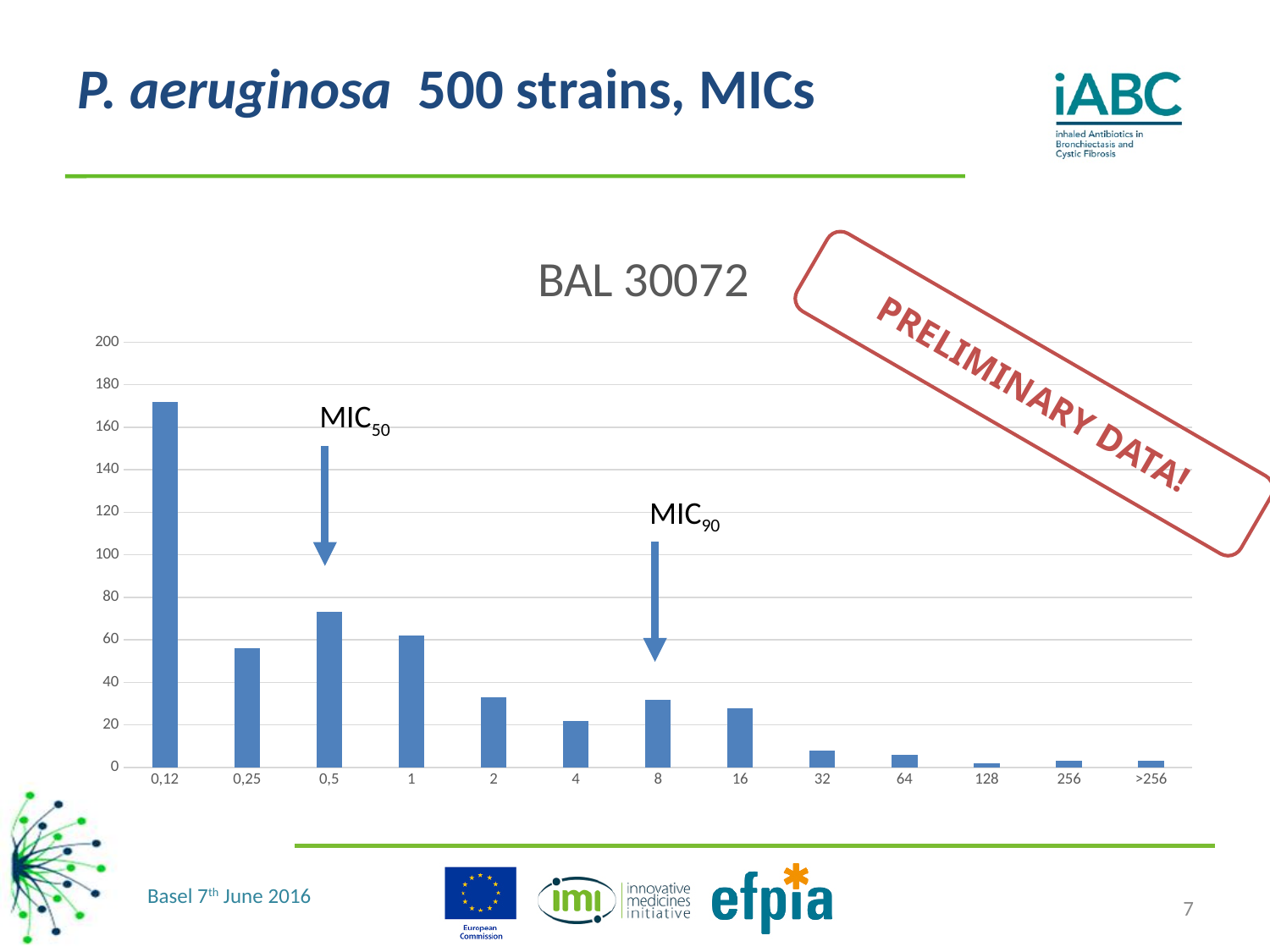
Which is larger, the value for 2 or the value for 4? 2 Is the value for 32 greater or less than 20? less Which is larger, the value for 0,5 or the value for 0,25? 0,5 Is the value for 0,12 greater or less than 160? greater Is the value for 0,5 greater or less than 60? greater What kind of chart is shown on the slide? bar chart Which category does the MIC50 arrow point to? 0,5 How many categories are shown on the x axis of the chart? 13 What is the title of the chart? BAL 30072 Which category has the highest bar? 0,12